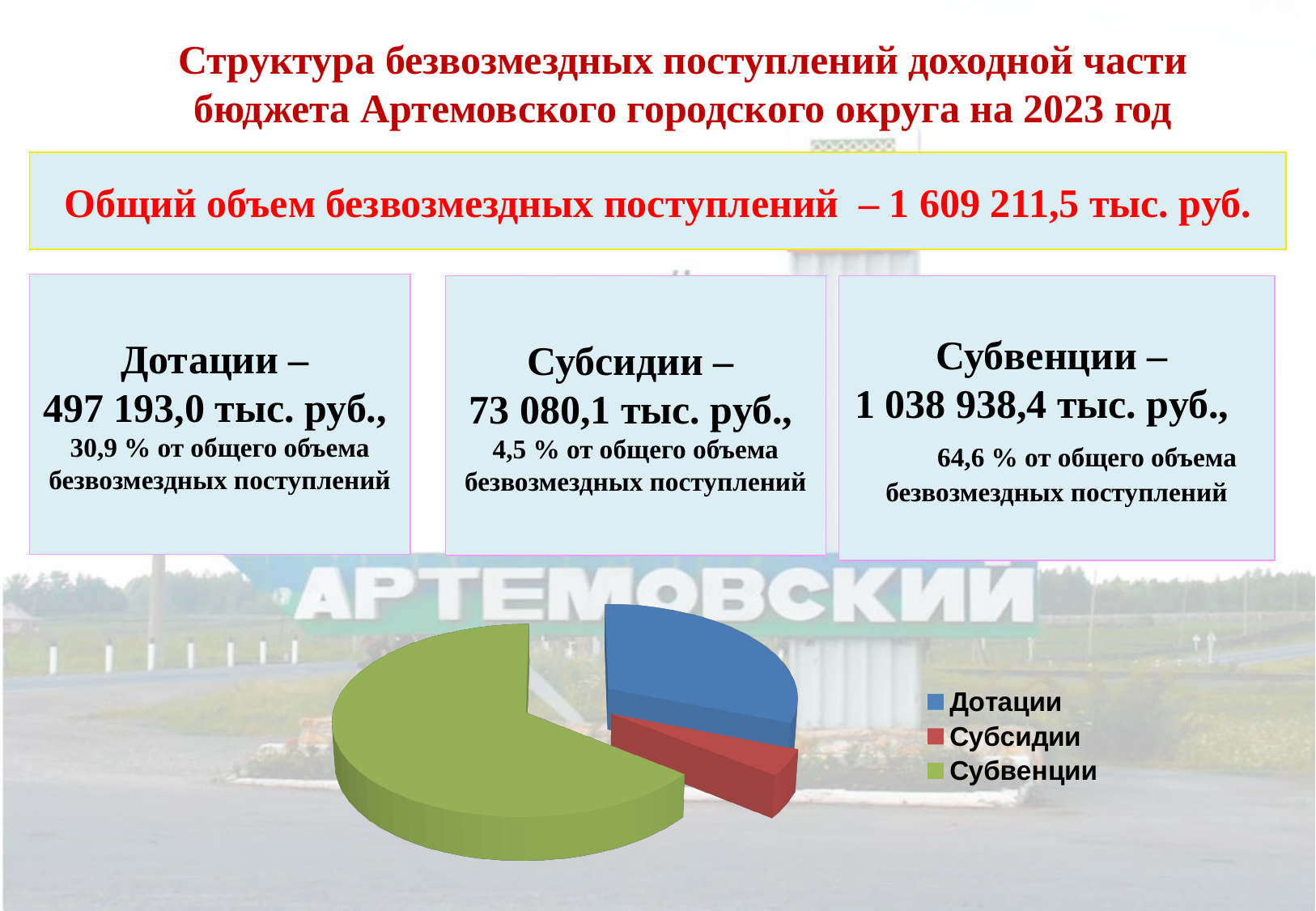
How many slices does the pie chart have? 3 What colour is the Субвенции slice in the pie chart? green How many entries does the legend of the pie chart list? 3 What is the value for Субсидии shown on the slide? 73 080,1 тыс. руб. Which slice is larger in the pie chart, Дотации or Субсидии? Дотации Which category has the smallest slice in the pie chart? Субсидии What kind of chart is shown on the slide? pie chart What is the total volume of gratuitous receipts shown on the slide? 1 609 211,5 тыс. руб. What is the value for Субвенции shown on the slide? 1 038 938,4 тыс. руб. What share of the total do Субвенции make up, according to the slide? 64,6 % What share of the total do Дотации make up, according to the slide? 30,9 % Which category has the largest slice in the pie chart? Субвенции